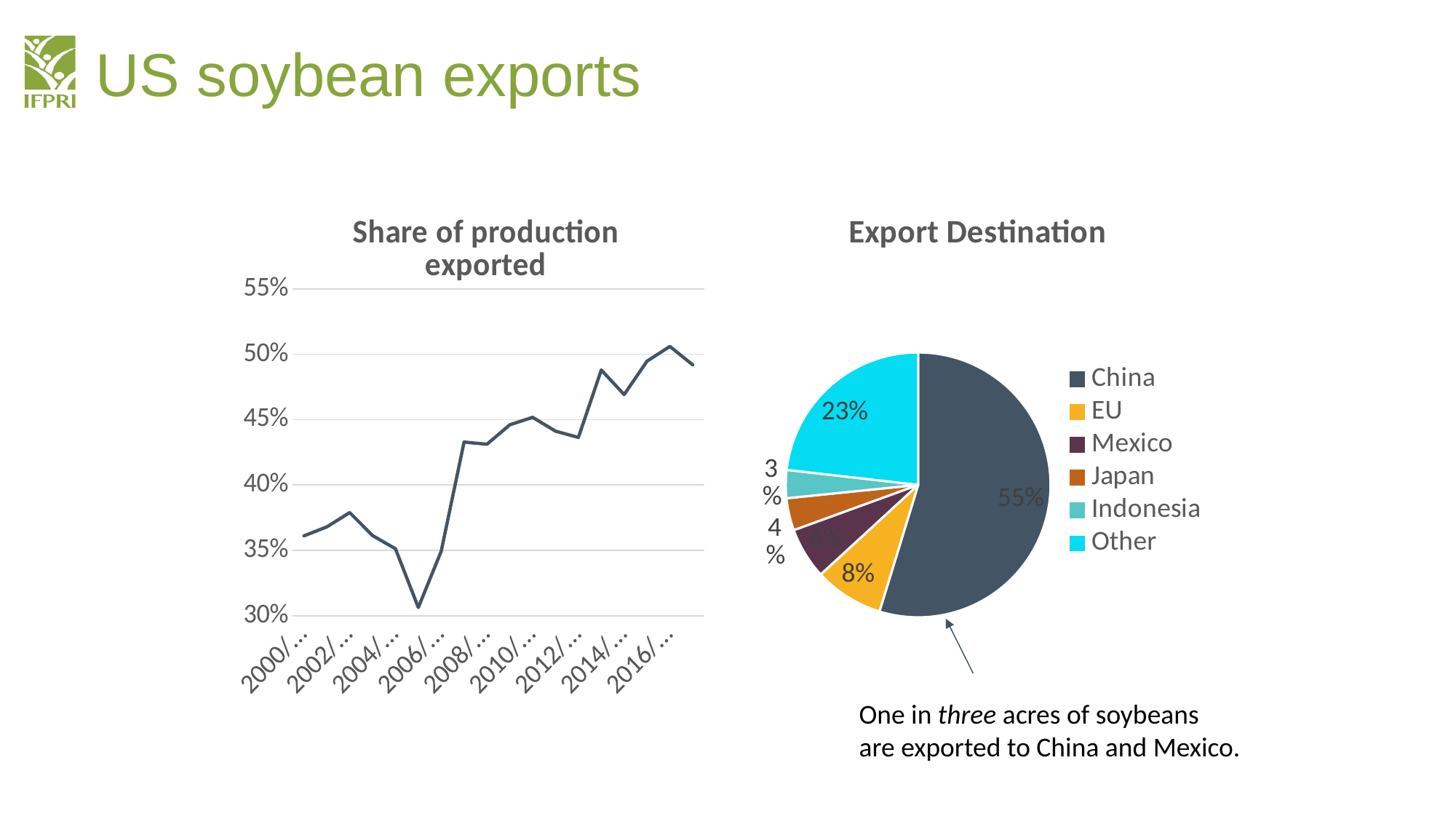
How many entries does the legend of the Export Destination chart list? 6 In the Export Destination chart, what share of exports goes to the EU? 8% In the Export Destination chart, which is larger, the share for Japan or the share for Mexico? Mexico In the Export Destination chart, what share of exports goes to China? 55% What kind of chart is the Share of production exported chart? Line chart In the Export Destination chart, what share of exports goes to Mexico? 6% In the Export Destination chart, which destination has the largest share? China In the Export Destination chart, what is the difference between the shares for China and Other? 32% In the Export Destination chart, what share of exports goes to Other destinations? 23% In the Share of production exported chart, do the values generally rise or fall from 2000/... to 2016/...? Rise In the Export Destination chart, which destination has the smallest share? Indonesia